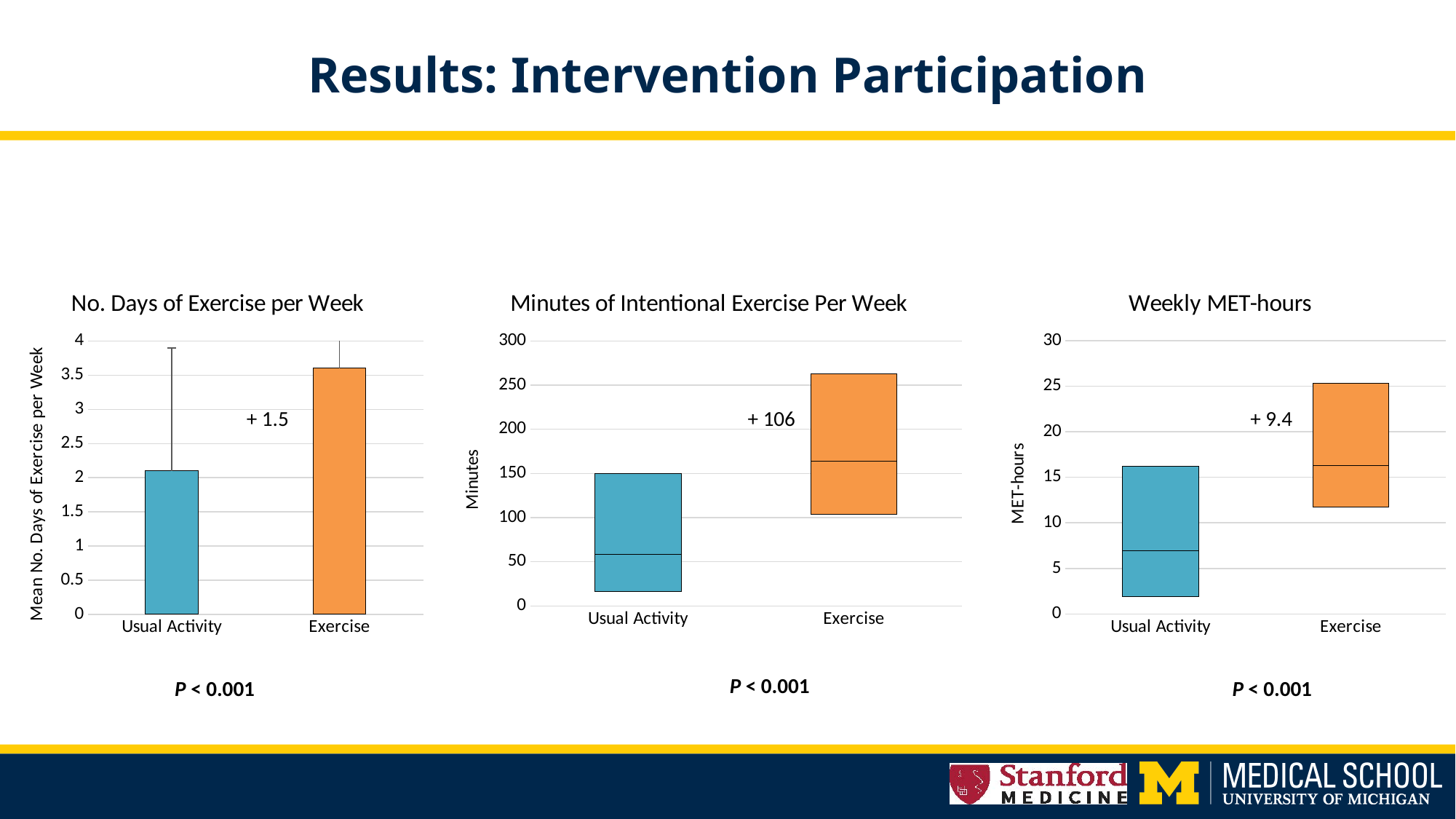
In the 'Weekly MET-hours' chart, what difference is annotated between the two groups? + 9.4 In the 'No. Days of Exercise per Week' chart, is the value for Exercise greater or less than 3? greater In the 'Minutes of Intentional Exercise Per Week' chart, is the median line for Usual Activity greater or less than 100? less In the 'No. Days of Exercise per Week' chart, what kind of chart is shown? bar chart How many categories are shown on the x axis of the 'Minutes of Intentional Exercise Per Week' chart? 2 In the 'No. Days of Exercise per Week' chart, which category has the higher bar? Exercise In the 'Minutes of Intentional Exercise Per Week' chart, what difference is annotated between the two groups? + 106 In the 'No. Days of Exercise per Week' chart, what difference is annotated between the two groups? + 1.5 In the 'Minutes of Intentional Exercise Per Week' chart, is the median line for Exercise greater or less than 150? greater What P value is printed beneath the 'Weekly MET-hours' chart? P < 0.001